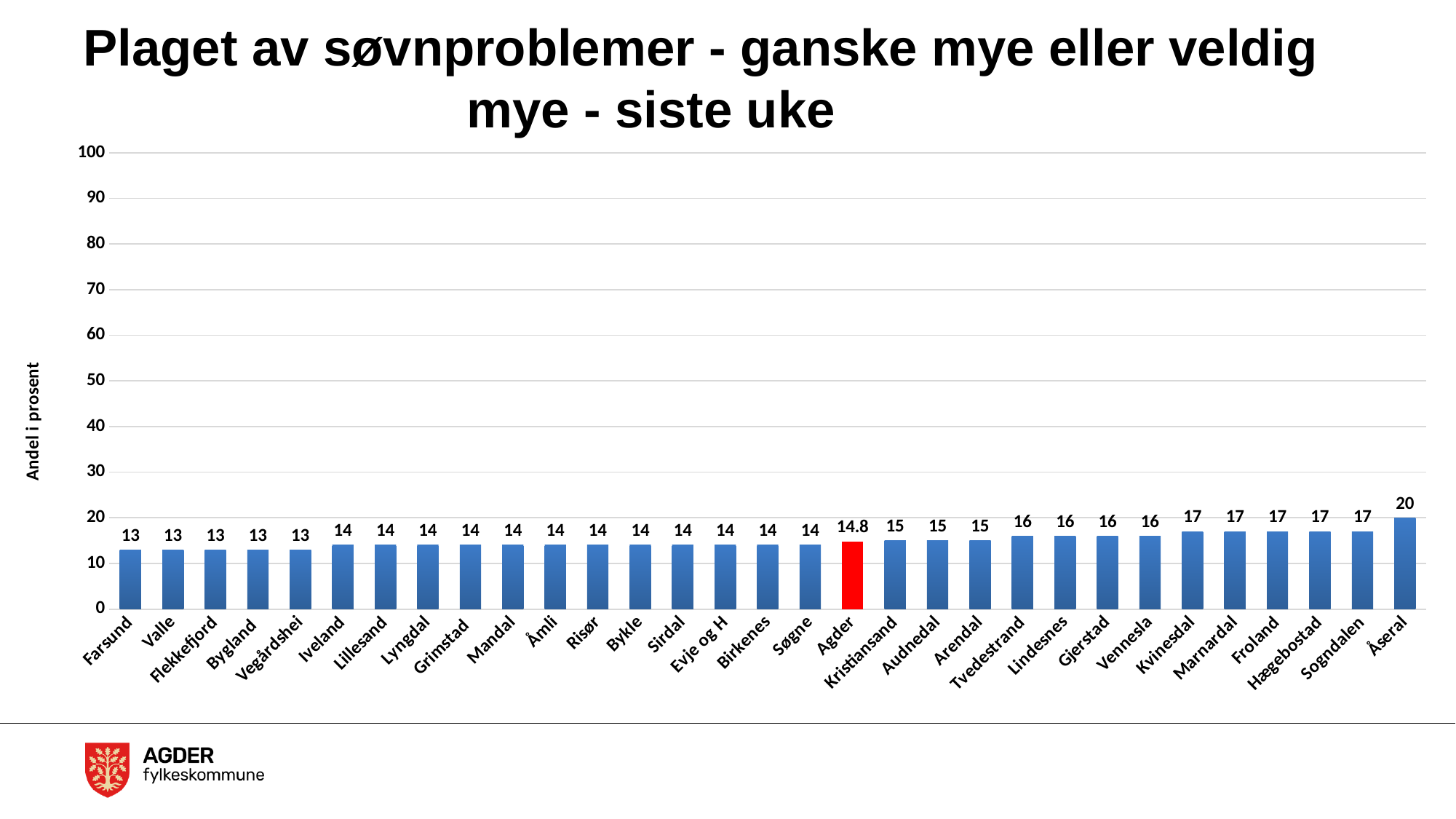
Is the value for Åseral greater or less than 30? less Which category has the highest value? Åseral What is the difference between the values for Kvinesdal and Agder? 2.2 What is the value for Kristiansand? 15 Which has a larger value, Tvedestrand or Valle? Tvedestrand What is the value for Agder? 14.8 What is the difference between the values for Åseral and Farsund? 7 What is the value for Åseral? 20 Which bar is coloured red instead of blue? Agder How many categories are shown on the x axis? 31 What is the value for Farsund? 13 What kind of chart is shown on the slide? bar chart